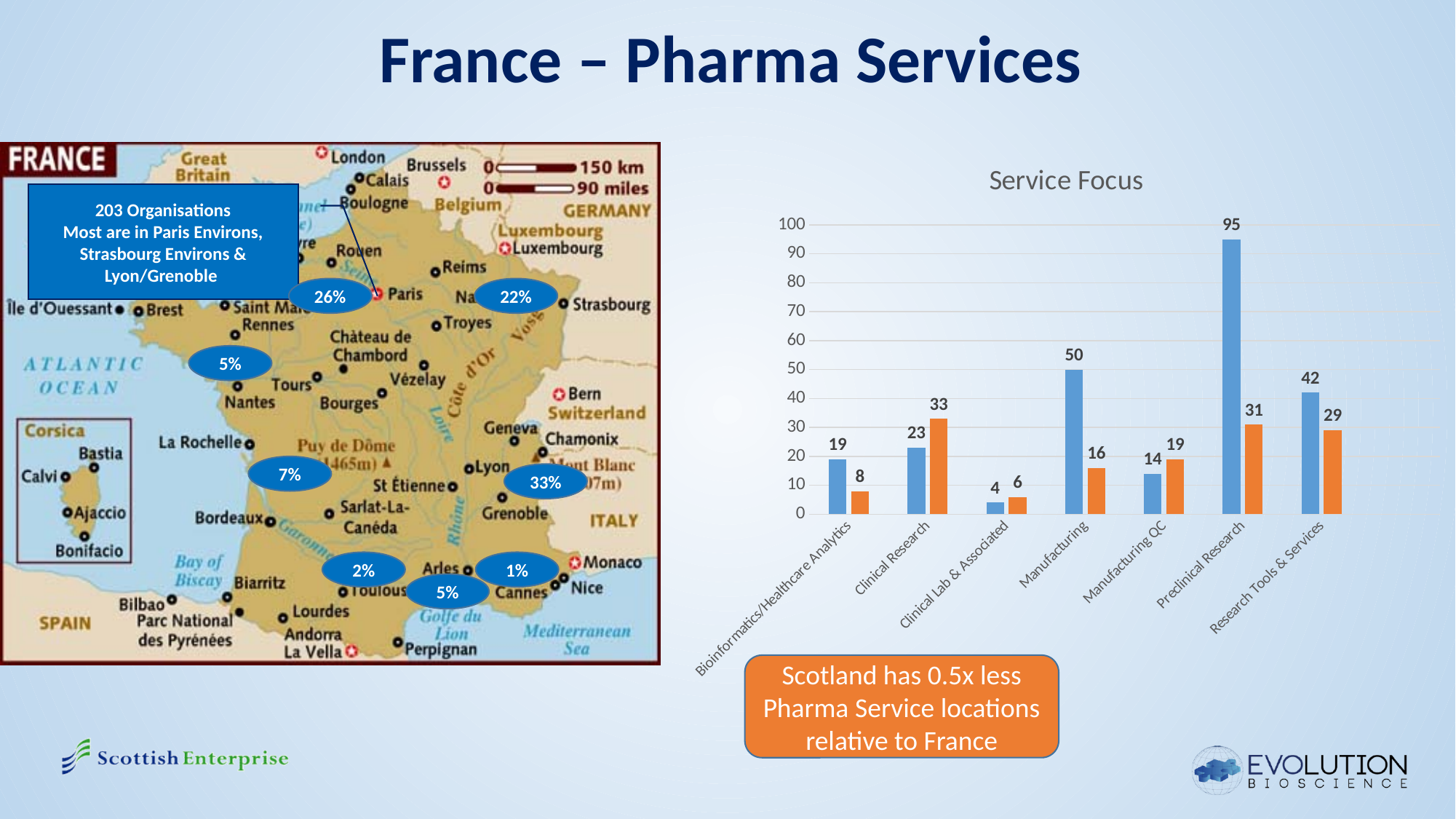
How many categories are shown on the x axis of the Service Focus chart? 7 In the Service Focus chart, what is the difference between the blue bars for Manufacturing and Research Tools & Services? 8 In the Service Focus chart, what is the value of the orange bar for Clinical Research? 33 In the Service Focus chart, is the blue bar for Research Tools & Services greater or less than 40? greater In the Service Focus chart, which category has the highest blue bar? Preclinical Research In the Service Focus chart, what is the difference between the blue and orange bars for Preclinical Research? 64 In the Service Focus chart, what is the value of the blue bar for Preclinical Research? 95 What kind of chart is the Service Focus chart? bar chart In the Service Focus chart, which category has the lowest orange bar? Clinical Lab & Associated In the Service Focus chart, what is the value of the blue bar for Manufacturing? 50 In the Service Focus chart, what is the value of the orange bar for Research Tools & Services? 29 In the Service Focus chart, which is larger for Manufacturing QC: the blue bar or the orange bar? the orange bar